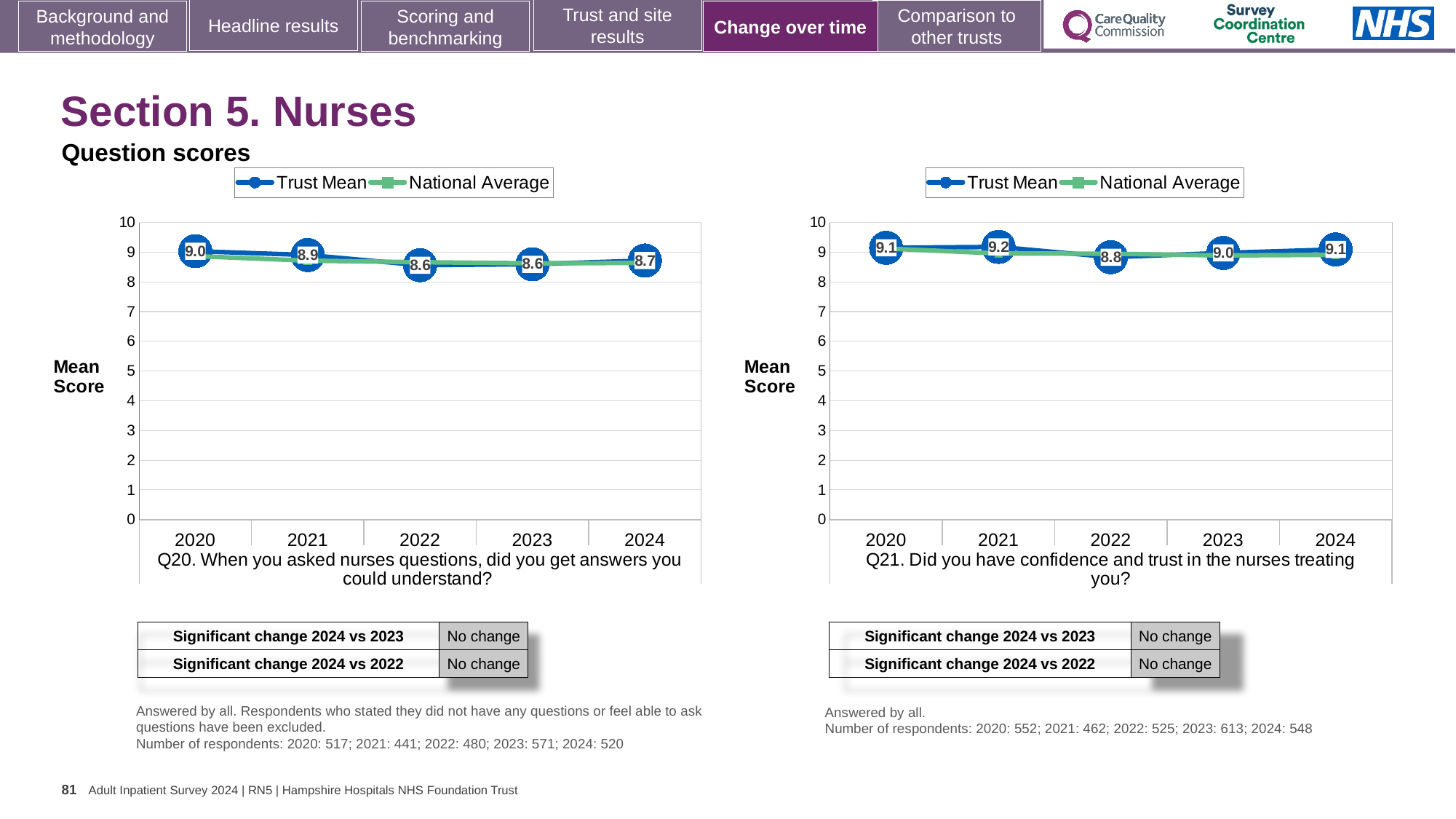
On the Q20 chart (left), what is the Trust Mean score for 2024? 8.7 On the Q21 chart (right), which year has the lowest Trust Mean score? 2022 What kind of chart is the Q20 chart (left)? Line chart On the Q20 chart (left), what is the Trust Mean score for 2020? 9.0 On the Q21 chart (right), is the Trust Mean value for 2024 greater or less than 8? greater On the Q21 chart (right), which year has the highest Trust Mean score? 2021 How many series does the legend of the Q21 chart (right) list? 2 On the Q21 chart (right), what is the Trust Mean score for 2022? 8.8 On the Q21 chart (right), is the Trust Mean score for 2021 larger or smaller than the score for 2023? larger On the Q20 chart (left), what is the difference between the Trust Mean scores for 2020 and 2022? 0.4 On the Q20 chart (left), how many years are shown on the x axis? 5 On the Q20 chart (left), which year has the highest Trust Mean score? 2020